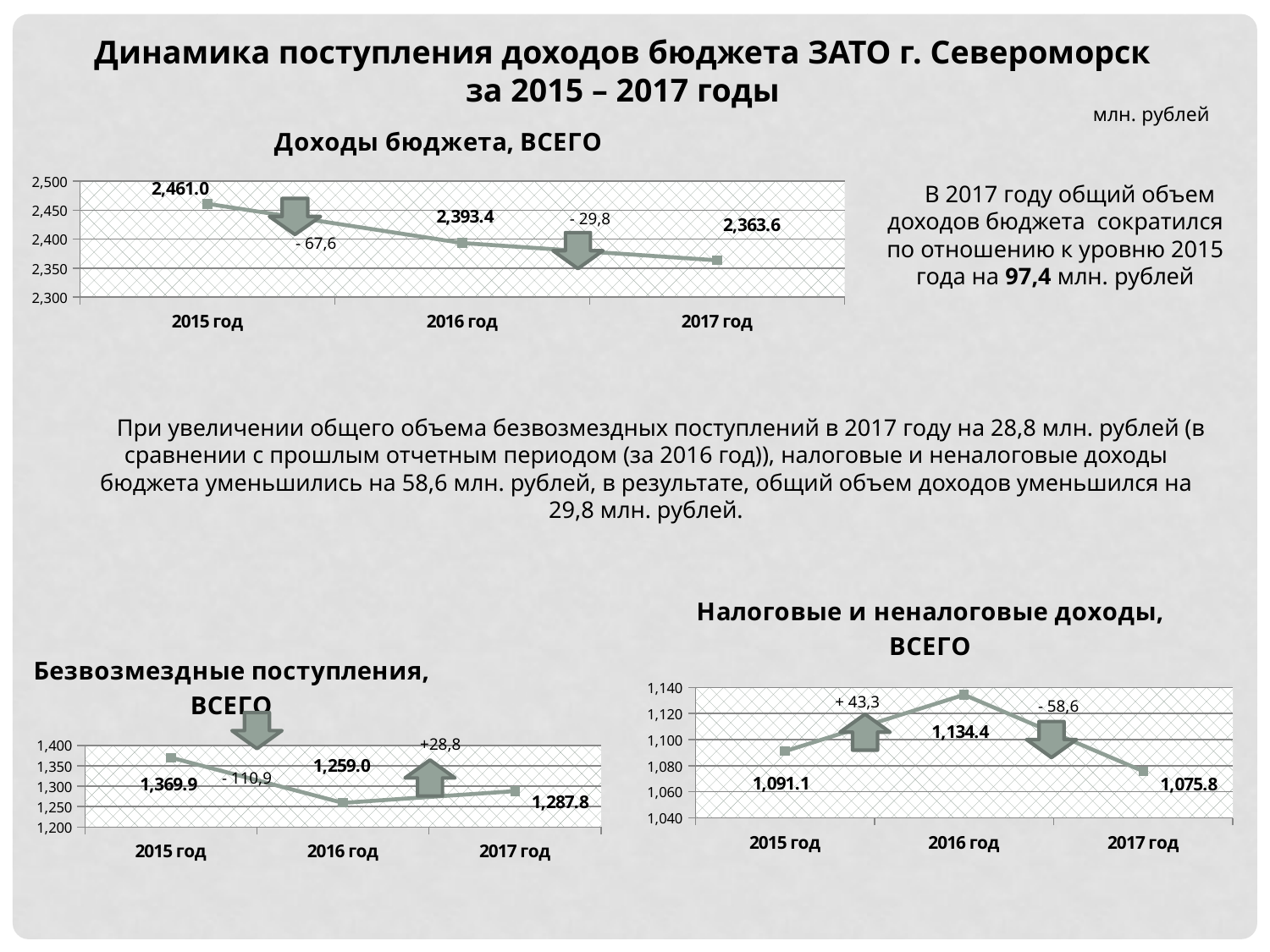
What type of chart is 'Доходы бюджета, ВСЕГО'? line chart In the chart 'Доходы бюджета, ВСЕГО', what is the difference between the 2015 год and 2016 год values? 67.6 In the chart 'Налоговые и неналоговые доходы, ВСЕГО', what is the value for 2016 год? 1,134.4 In the chart 'Безвозмездные поступления, ВСЕГО', which year has the highest value? 2015 год In the chart 'Налоговые и неналоговые доходы, ВСЕГО', which year has the lowest value? 2017 год In the chart 'Безвозмездные поступления, ВСЕГО', what is the value for 2016 год? 1,259.0 In the chart 'Доходы бюджета, ВСЕГО', what is the value for 2015 год? 2,461.0 In the chart 'Безвозмездные поступления, ВСЕГО', what is the difference between the 2017 год and 2016 год values? 28.8 In the chart 'Налоговые и неналоговые доходы, ВСЕГО', which is larger: the value for 2015 год or 2017 год? 2015 год In the chart 'Доходы бюджета, ВСЕГО', do the values rise or fall from 2015 год to 2017 год? fall How many data points are plotted in the chart 'Налоговые и неналоговые доходы, ВСЕГО'? 3 In the chart 'Доходы бюджета, ВСЕГО', what is the value for 2017 год? 2,363.6